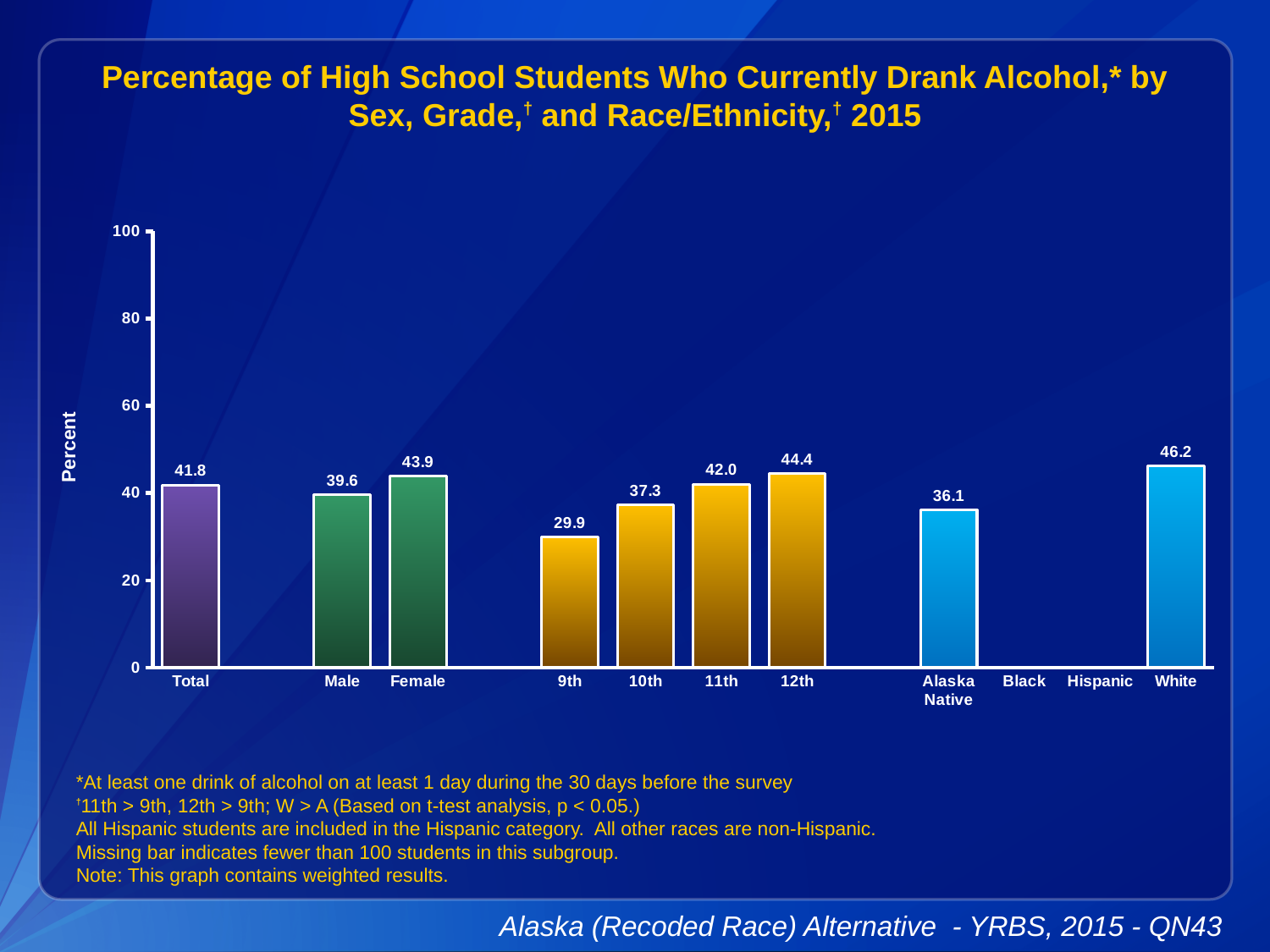
What is the value for 9th grade? 29.9 Which is larger, the value for Male or the value for Female? Female Do the values rise or fall from 9th grade to 12th grade? rise What is the value for Total? 41.8 Which category has the lowest value among the plotted bars? 9th What is the value for Alaska Native? 36.1 How many bars are plotted on the chart? 9 What kind of chart is shown? bar chart Which category has the highest value? White What is the difference between the values for 12th and 9th grade? 14.5 Is the value for 10th grade greater or less than 40? less What is the value for Female? 43.9